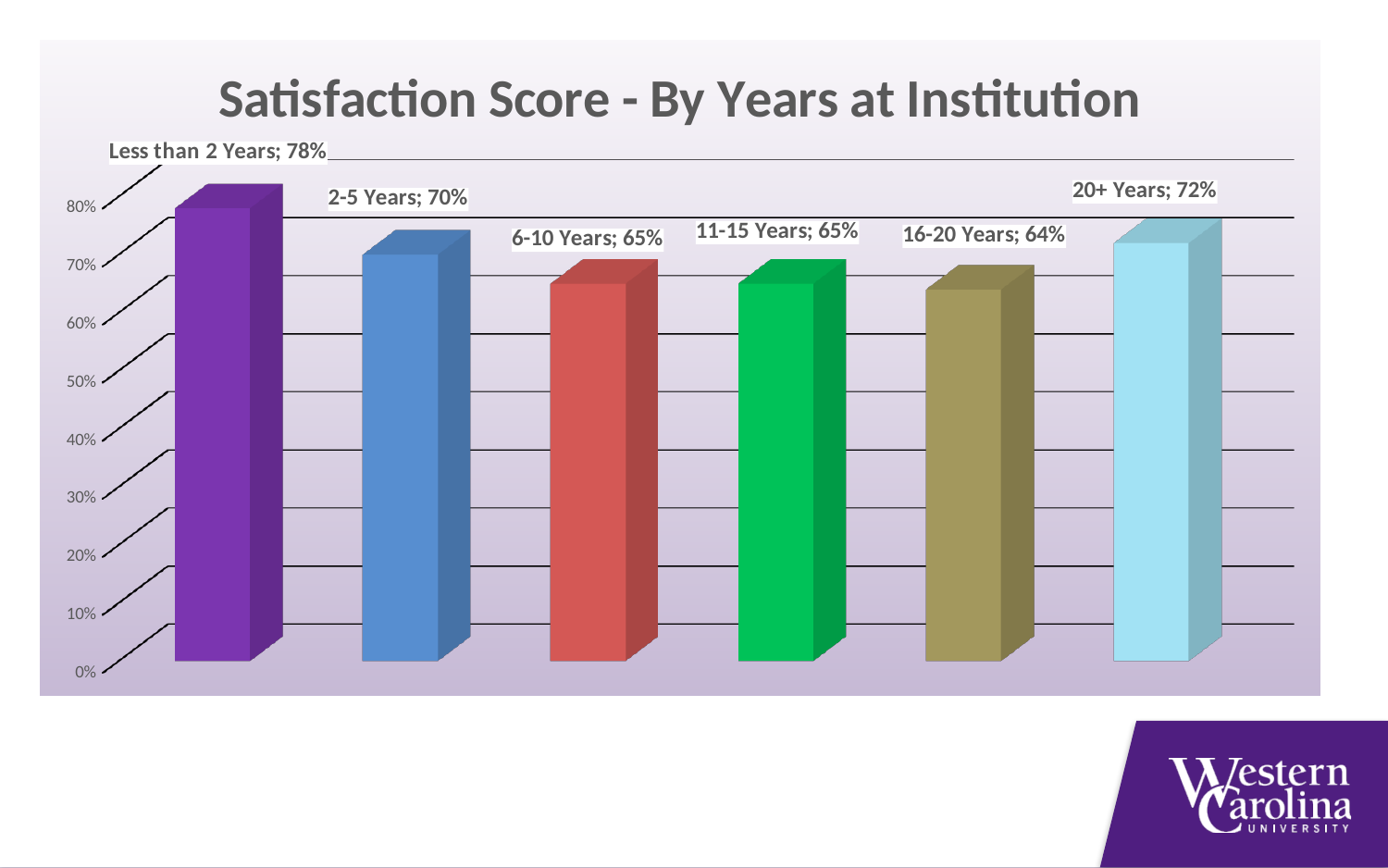
Which group has the lowest satisfaction score? 16-20 Years What kind of chart is shown on the slide? Bar chart What is the satisfaction score for the '20+ Years' group? 72% What is the difference between the satisfaction scores of '20+ Years' and '2-5 Years'? 2% How many year-at-institution groups are shown in the chart? 6 What is the satisfaction score for the '16-20 Years' group? 64% Which has a higher satisfaction score, '2-5 Years' or '20+ Years'? 2-5 Years Which group has the highest satisfaction score? Less than 2 Years What is the satisfaction score for the 'Less than 2 Years' group? 78% What is the title of the chart? Satisfaction Score - By Years at Institution What is the satisfaction score for the '2-5 Years' group? 70% What is the difference between the satisfaction scores of 'Less than 2 Years' and '16-20 Years'? 14%